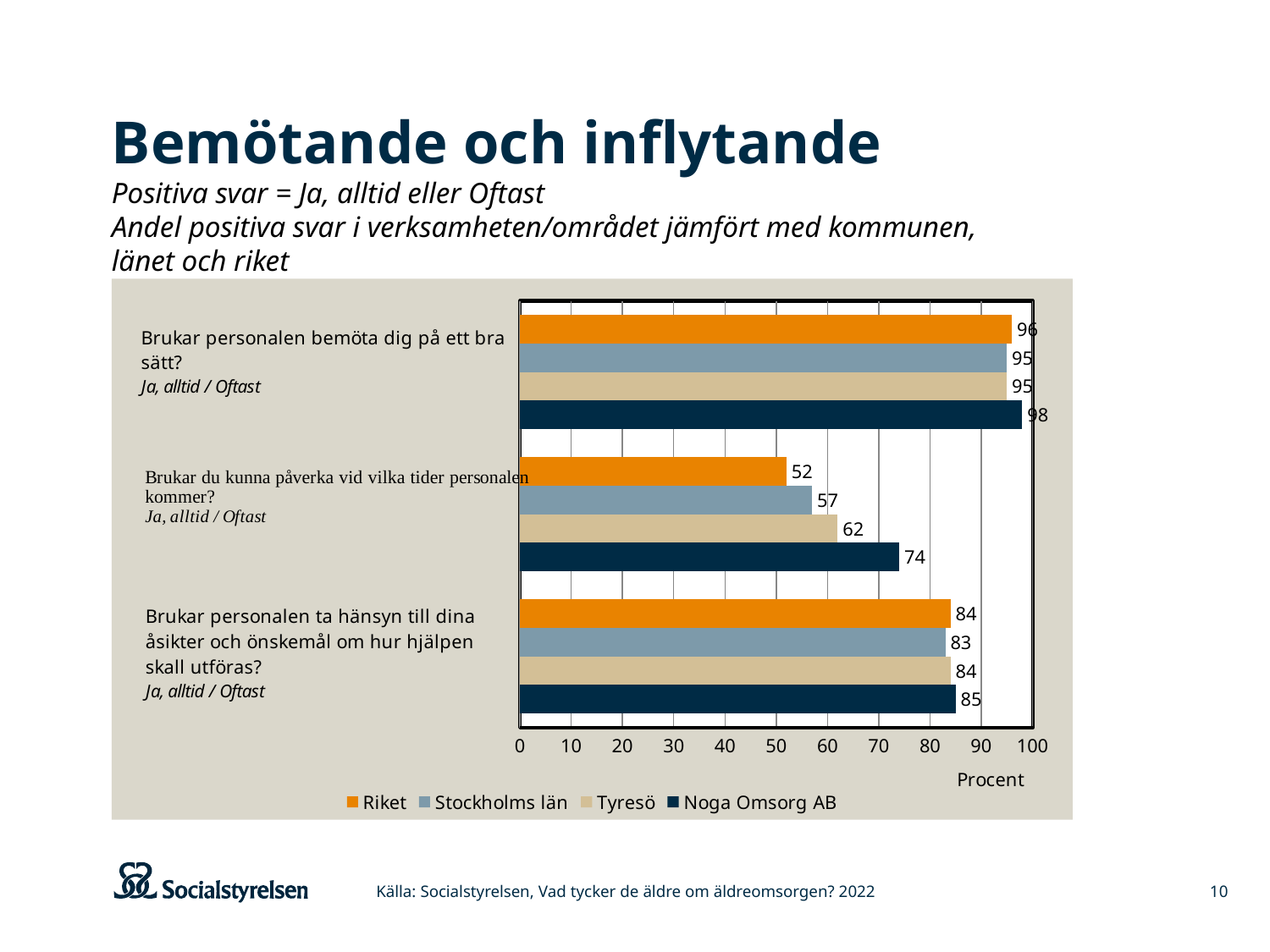
On the question "Brukar personalen bemöta dig på ett bra sätt?", which is larger: the value for Noga Omsorg AB or the value for Riket? Noga Omsorg AB Is the value for Tyresö on the question "Brukar du kunna påverka vid vilka tider personalen kommer?" greater or less than 50? greater What is the value for Tyresö on the question "Brukar personalen ta hänsyn till dina åsikter och önskemål om hur hjälpen skall utföras?"? 84 What is the value for Stockholms län on the question "Brukar du kunna påverka vid vilka tider personalen kommer?"? 57 How many series does the legend list? 4 What is the value for Riket on the question "Brukar personalen bemöta dig på ett bra sätt?"? 96 Which series has the highest value on the question "Brukar du kunna påverka vid vilka tider personalen kommer?"? Noga Omsorg AB How many question categories are shown on the chart? 3 Which series has the lowest value on the question "Brukar du kunna påverka vid vilka tider personalen kommer?"? Riket What is the difference between the Noga Omsorg AB value and the Riket value on the question "Brukar du kunna påverka vid vilka tider personalen kommer?"? 22 What kind of chart is shown on the slide? Bar chart What is the value for Noga Omsorg AB on the question "Brukar du kunna påverka vid vilka tider personalen kommer?"? 74